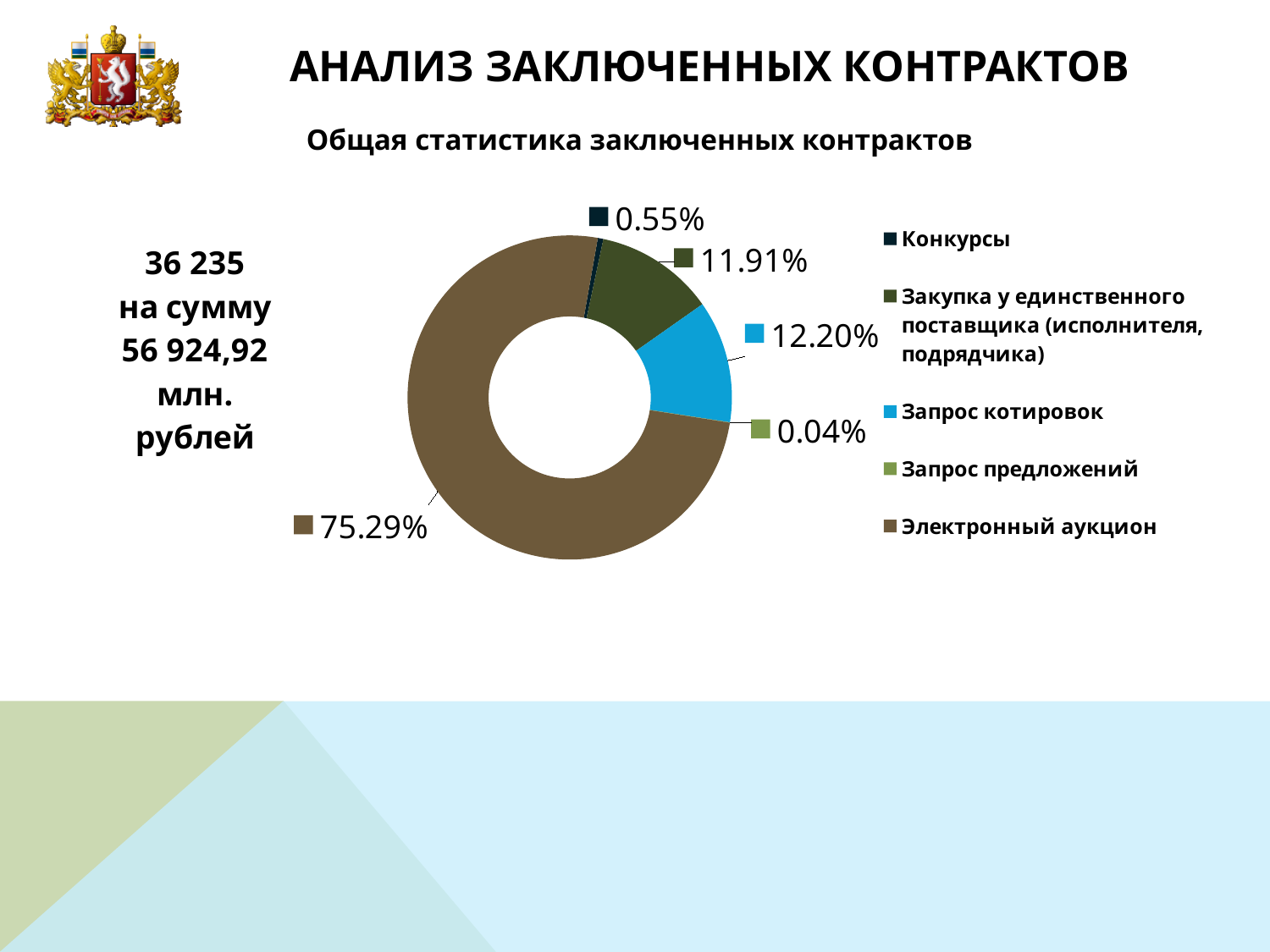
What is the title of the chart? Общая статистика заключенных контрактов What share of the chart does Электронный аукцион account for? 75.29% What kind of chart is shown on the slide? doughnut chart Which category has the largest share of the chart? Электронный аукцион What is the value shown for Запрос котировок? 12.20% What is the difference between the shares for Запрос котировок and Закупка у единственного поставщика (исполнителя, подрядчика)? 0.29% What is the value shown for Конкурсы? 0.55% What percentage is shown for Закупка у единственного поставщика (исполнителя, подрядчика)? 11.91% Which category has the smallest share of the chart? Запрос предложений Which is larger, the share for Запрос котировок or the share for Закупка у единственного поставщика (исполнителя, подрядчика)? Запрос котировок How many categories does the chart show? 5 What is the value shown for Запрос предложений? 0.04%